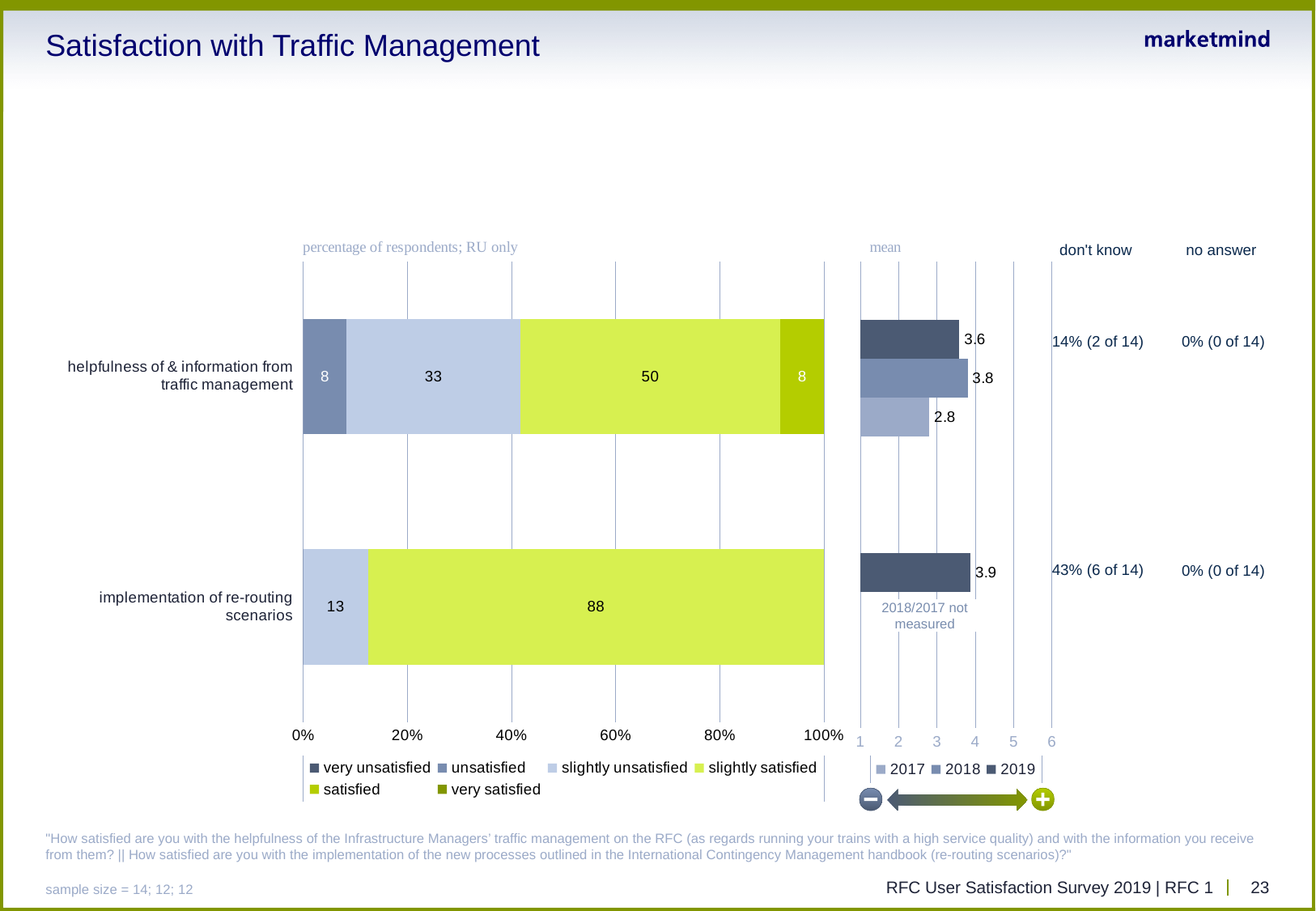
In the mean chart, what is the 2019 mean for helpfulness of & information from traffic management? 3.6 In the mean chart, what is the 2019 mean for implementation of re-routing scenarios? 3.9 In the percentage-of-respondents chart, what percentage of respondents were slightly satisfied with the helpfulness of & information from traffic management? 50 In the mean chart, is the 2019 mean for implementation of re-routing scenarios larger or smaller than the 2019 mean for helpfulness of & information from traffic management? larger How many series does the legend of the mean chart list? 3 In the percentage-of-respondents chart, what percentage of respondents were slightly unsatisfied with the helpfulness of & information from traffic management? 33 In the mean chart, which year has the lowest mean for helpfulness of & information from traffic management? 2017 In the mean chart, what is the 2017 mean for helpfulness of & information from traffic management? 2.8 In the mean chart, what is the difference between the 2018 and 2017 means for helpfulness of & information from traffic management? 1.0 What kind of chart is the percentage-of-respondents chart? stacked bar chart In the percentage-of-respondents chart, what percentage of respondents were slightly unsatisfied with the implementation of re-routing scenarios? 13 In the percentage-of-respondents chart, what percentage of respondents were slightly satisfied with the implementation of re-routing scenarios? 88